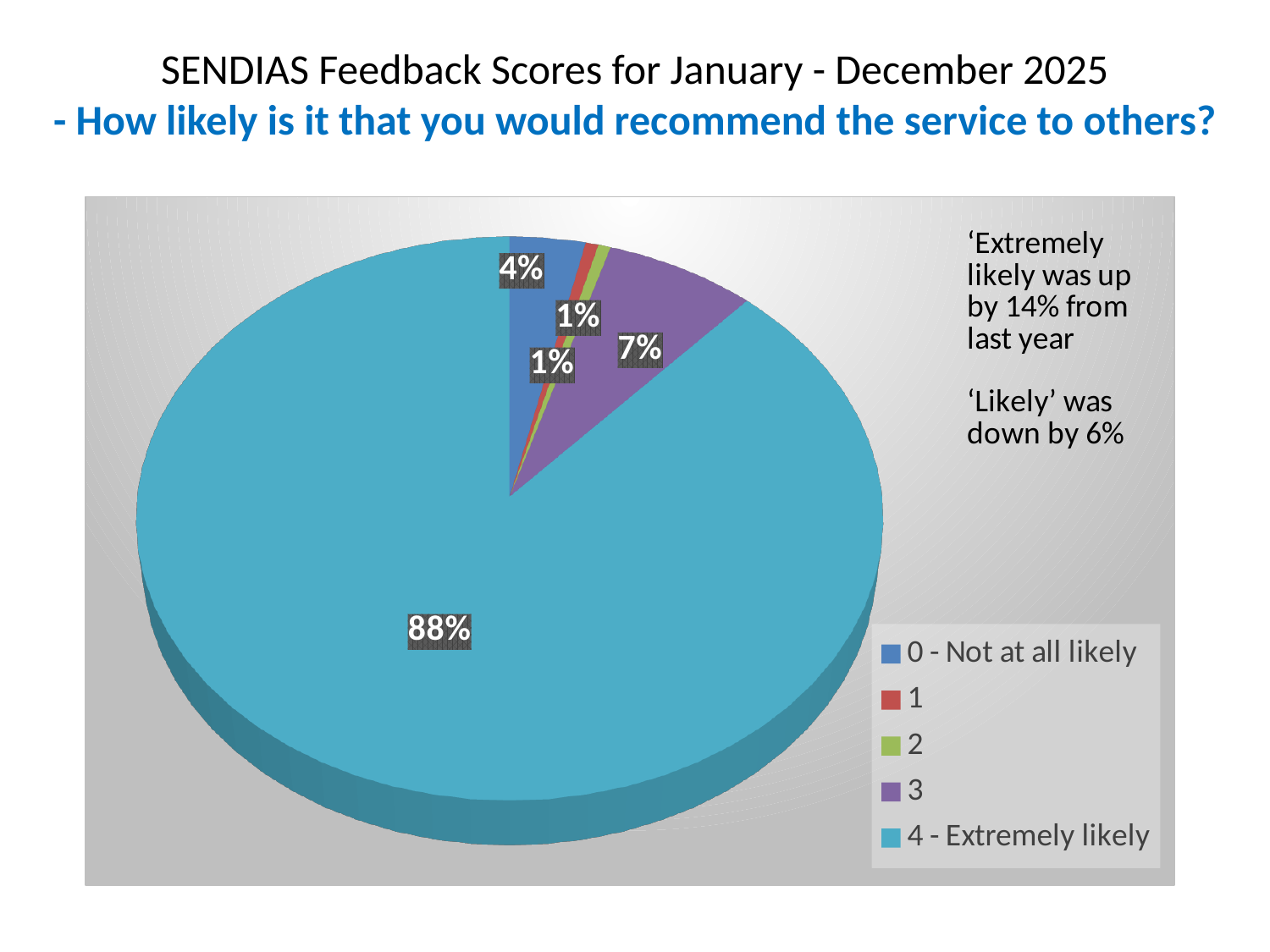
What share of the pie is the category '3'? 7% According to the text on the slide, by how much was 'Extremely likely' up from last year? 14% What is the combined share of the '0 - Not at all likely' and '3' slices? 11% What share of the pie is '0 - Not at all likely'? 4% What is the difference in percentage points between the '4 - Extremely likely' slice and the '3' slice? 81 Which is larger, the slice for '3' or the slice for '0 - Not at all likely'? 3 What type of chart is shown on the slide? pie chart Which category has the largest slice of the pie? 4 - Extremely likely What share of the pie is '4 - Extremely likely'? 88% How many categories does the legend list? 5 What colour is the '4 - Extremely likely' slice? teal/light blue